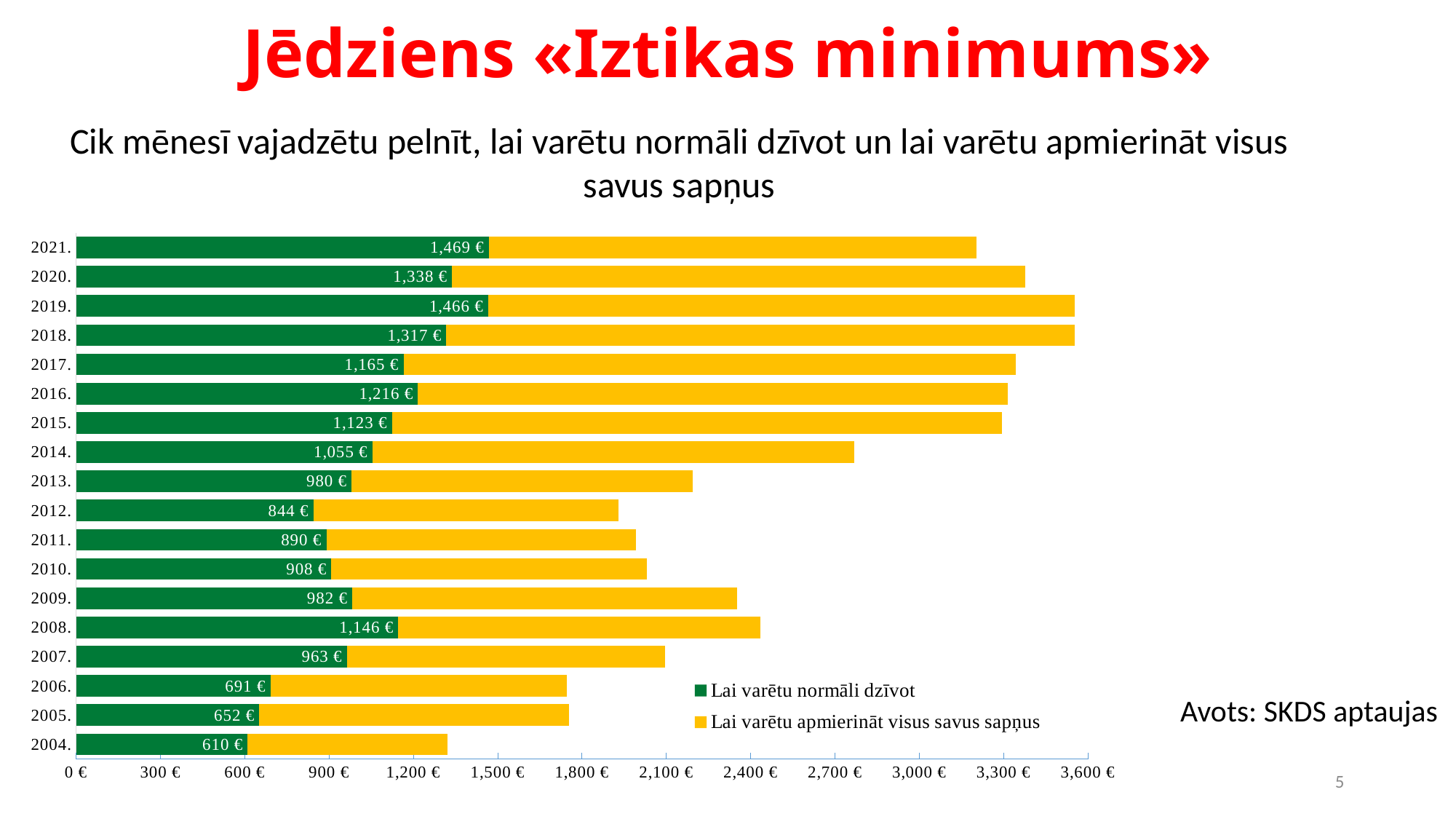
Which year has the larger "Lai varētu normāli dzīvot" value, 2019 or 2020? 2019 How many years are shown on the chart? 18 What is the value of "Lai varētu normāli dzīvot" for 2012? 844 € What kind of chart is shown on the slide? bar chart Which year has the highest value for "Lai varētu normāli dzīvot"? 2021 What is the value of "Lai varētu normāli dzīvot" for 2004? 610 € Which year has the lowest value for "Lai varētu normāli dzīvot"? 2004 What is the value of "Lai varētu normāli dzīvot" for 2021? 1,469 € How many series does the legend list? 2 Which series is shown in yellow? Lai varētu apmierināt visus savus sapņus Is the total length of the stacked bar for 2019 greater or less than 3,300 €? greater What is the difference between the "Lai varētu normāli dzīvot" values for 2021 and 2004? 859 €